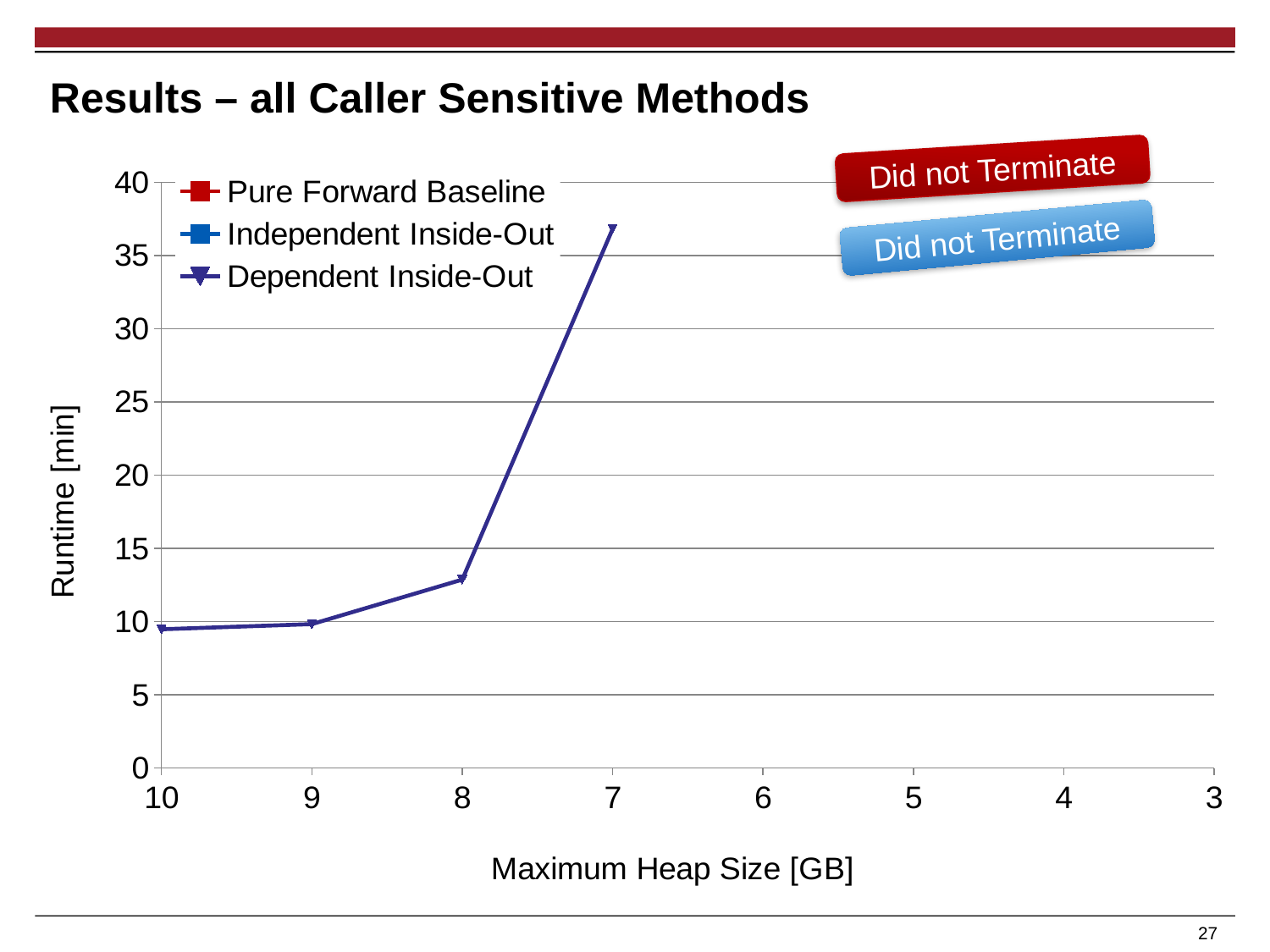
What kind of chart is shown on the slide? line chart How many heap-size values are marked on the x axis? 8 Is the runtime for Dependent Inside-Out at a maximum heap size of 8 GB greater or less than 10? greater Is the runtime for Dependent Inside-Out at a maximum heap size of 7 GB greater or less than 40? less What is the label of the x axis? Maximum Heap Size [GB] Is the runtime for Dependent Inside-Out at a maximum heap size of 9 GB greater or less than 15? less How many series does the legend list? 3 What is the label of the y axis? Runtime [min] Does the plotted runtime rise or fall as you move from left to right along the x axis? rise Which has the larger runtime for Dependent Inside-Out: a maximum heap size of 8 GB or 7 GB? 7 GB At which maximum heap size is the plotted runtime for Dependent Inside-Out highest? 7